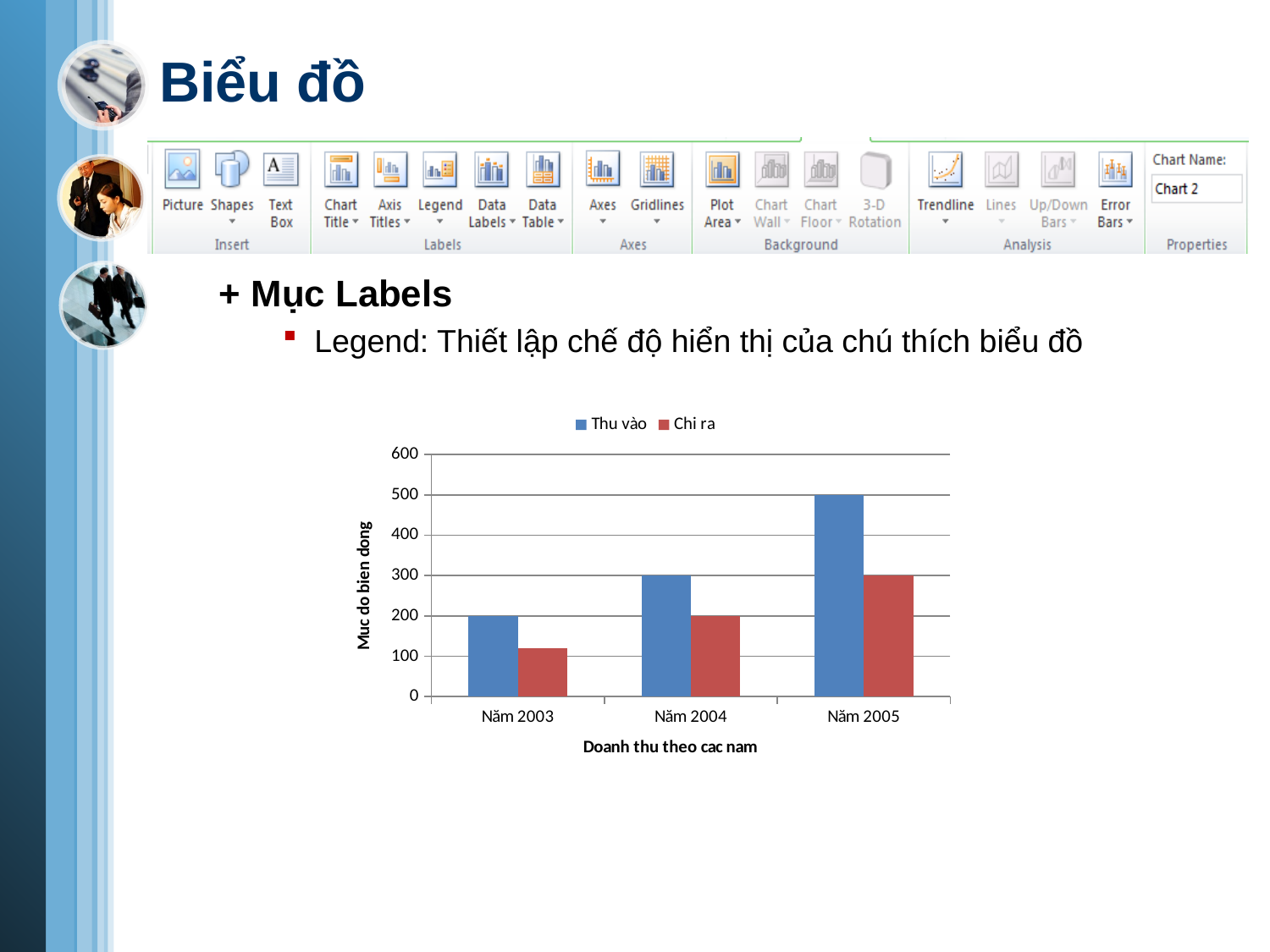
What is the value of Thu vào for Năm 2005? 500 Which year has the lowest Chi ra value? Năm 2003 Which is larger for Năm 2004, Thu vào or Chi ra? Thu vào Is the Chi ra value for Năm 2003 greater or less than 200? less Which year has the highest Thu vào value? Năm 2005 How many series does the chart legend list? 2 What is the difference between Thu vào and Chi ra for Năm 2005? 200 What is the value of Thu vào for Năm 2003? 200 How many categories are shown on the x axis of the chart? 3 What is the value of Chi ra for Năm 2004? 200 Do the Thu vào values rise or fall from Năm 2003 to Năm 2005? rise What kind of chart is shown on the slide? bar chart